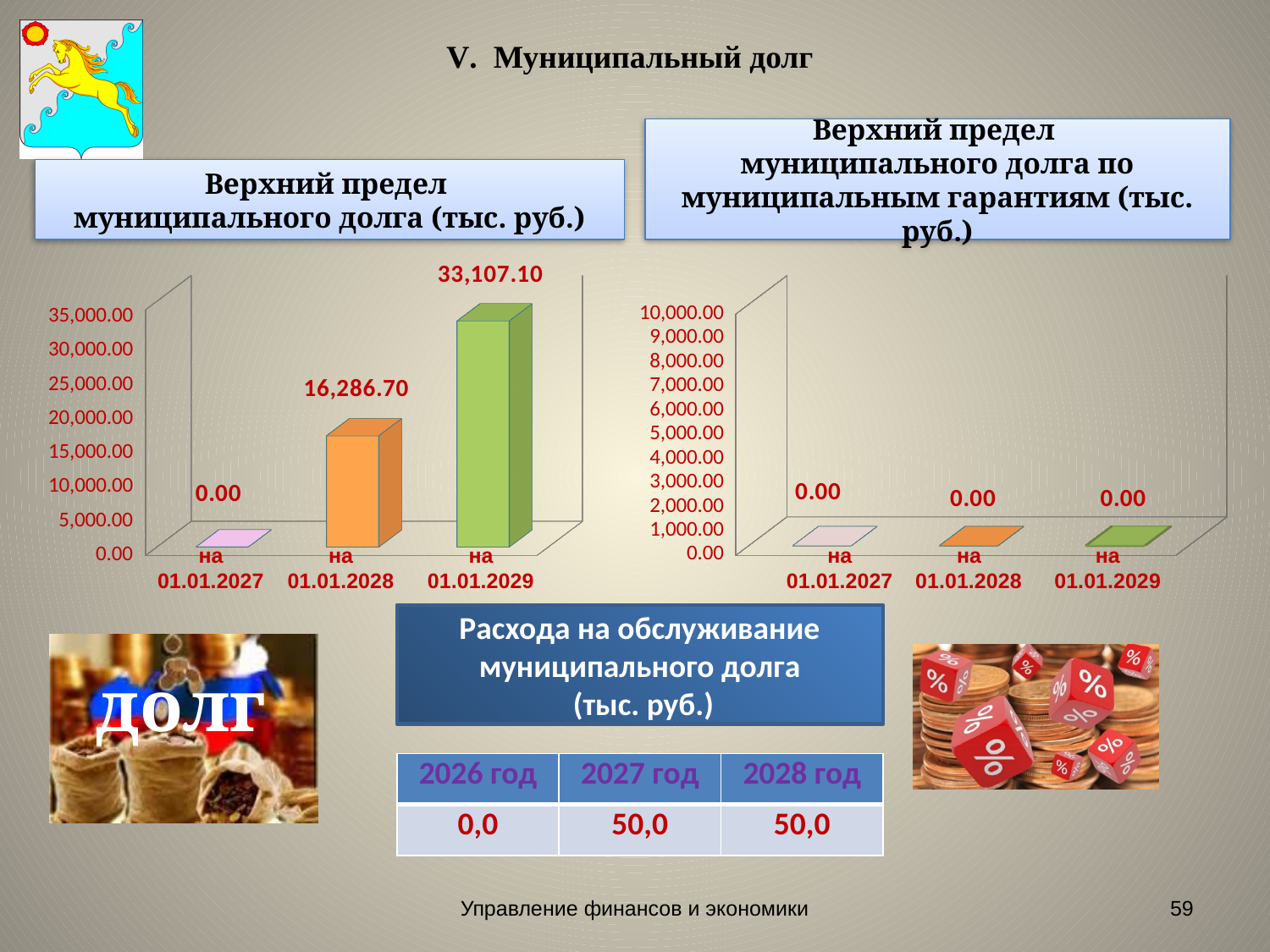
In the left chart (Верхний предел муниципального долга), what is the value for на 01.01.2028? 16,286.70 In the left chart (Верхний предел муниципального долга), which category has the highest value? на 01.01.2029 In the left chart (Верхний предел муниципального долга), is the value for на 01.01.2028 greater or less than 15,000.00? greater In the right chart (Верхний предел муниципального долга по муниципальным гарантиям), what is the highest value shown on the vertical axis? 10,000.00 In the left chart (Верхний предел муниципального долга), which category has the lowest value? на 01.01.2027 In the left chart (Верхний предел муниципального долга), do the values rise or fall from на 01.01.2027 to на 01.01.2029? rise In the left chart (Верхний предел муниципального долга), what is the difference between the values for на 01.01.2029 and на 01.01.2028? 16,820.40 In the right chart (Верхний предел муниципального долга по муниципальным гарантиям), what is the value for на 01.01.2029? 0.00 In the left chart (Верхний предел муниципального долга), how many categories are shown? 3 In the left chart (Верхний предел муниципального долга), what is the value for на 01.01.2027? 0.00 In the left chart (Верхний предел муниципального долга), what is the value for на 01.01.2029? 33,107.10 What kind of chart is the right chart (Верхний предел муниципального долга по муниципальным гарантиям)? bar chart